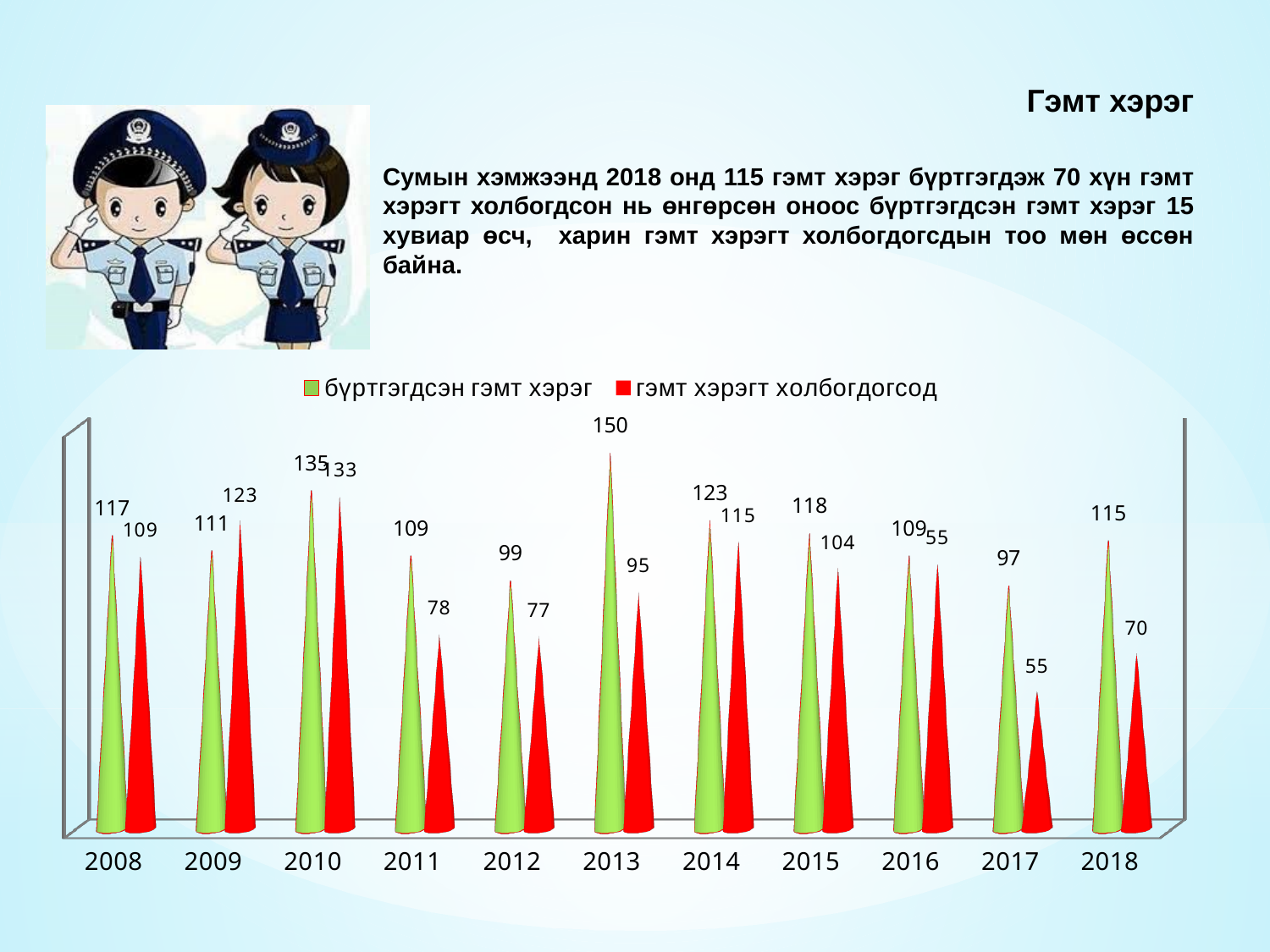
What kind of chart is shown on the slide? bar chart In 2009, which is larger: бүртгэгдсэн гэмт хэрэг or гэмт хэрэгт холбогдогсод? гэмт хэрэгт холбогдогсод What is the value of гэмт хэрэгт холбогдогсод for 2011? 78 Which year has the highest value for бүртгэгдсэн гэмт хэрэг? 2013 What is the value of бүртгэгдсэн гэмт хэрэг for 2013? 150 Which year has the lowest value for бүртгэгдсэн гэмт хэрэг? 2017 Which year has the lowest value for гэмт хэрэгт холбогдогсод? 2017 How many years are shown on the x axis of the chart? 11 What is the value of бүртгэгдсэн гэмт хэрэг for 2012? 99 How many series does the chart legend list? 2 What is the difference between бүртгэгдсэн гэмт хэрэг and гэмт хэрэгт холбогдогсод in 2018? 45 What is the value of гэмт хэрэгт холбогдогсод for 2018? 70